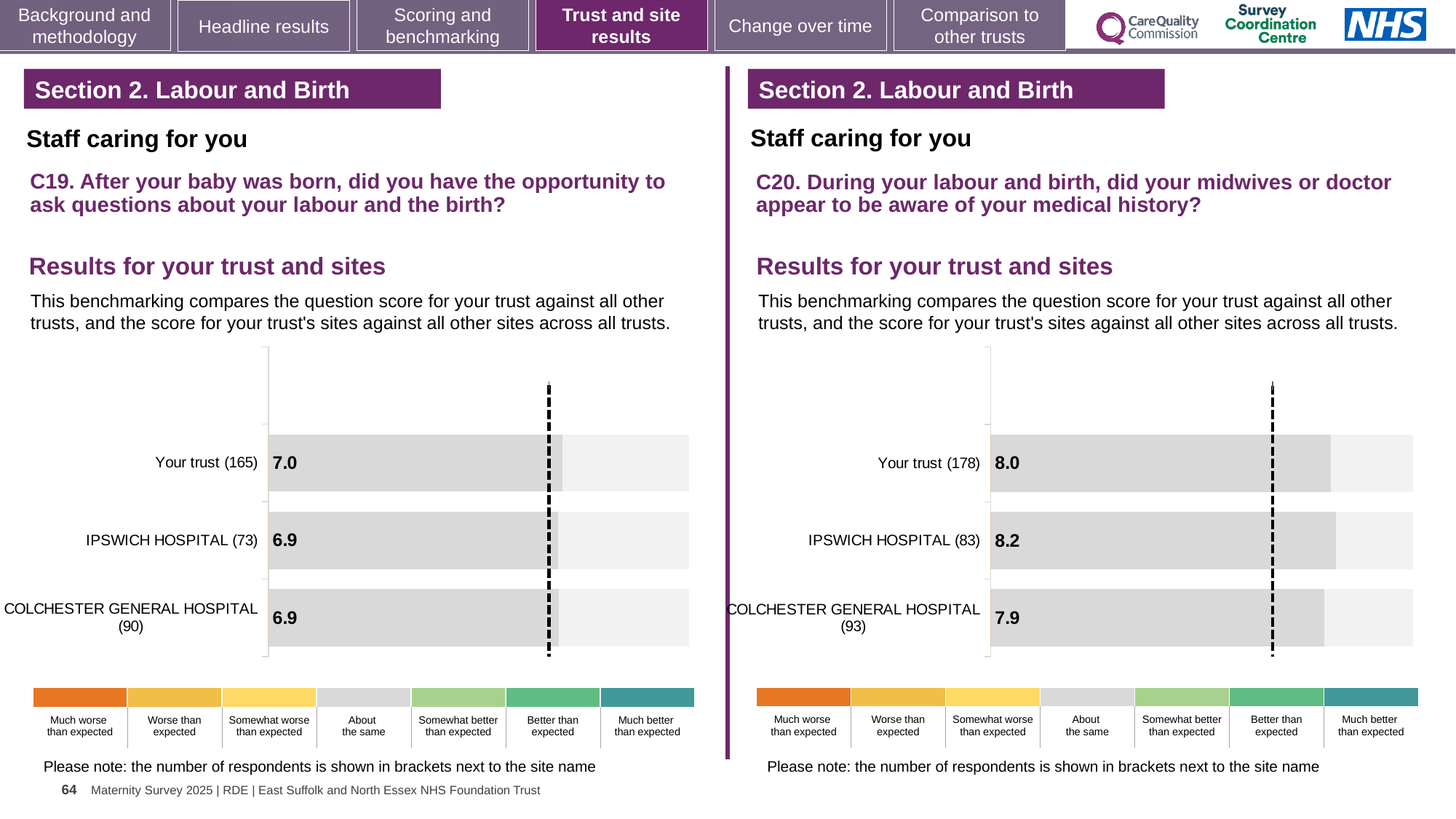
In the C19 chart on the left, what is the difference between the scores for Your trust and IPSWICH HOSPITAL? 0.1 In the C20 chart on the right, which site or trust has the highest score? IPSWICH HOSPITAL What type of chart is used for the C20 results on the right? Bar chart In the C19 chart on the left, what is the score for IPSWICH HOSPITAL? 6.9 In the C20 chart on the right, which site or trust has the lowest score? COLCHESTER GENERAL HOSPITAL In the C20 chart on the right, what is the score for Your trust? 8.0 In the C19 chart on the left, which has the highest score? Your trust In the C20 chart on the right, what is the score for COLCHESTER GENERAL HOSPITAL? 7.9 In the C20 chart on the right, which is larger: the score for IPSWICH HOSPITAL or the score for Your trust? IPSWICH HOSPITAL In the C20 chart on the right, what is the difference between the scores for IPSWICH HOSPITAL and COLCHESTER GENERAL HOSPITAL? 0.3 In the C19 chart on the left, what is the score for Your trust? 7.0 How many bars are shown in the C19 chart on the left? 3